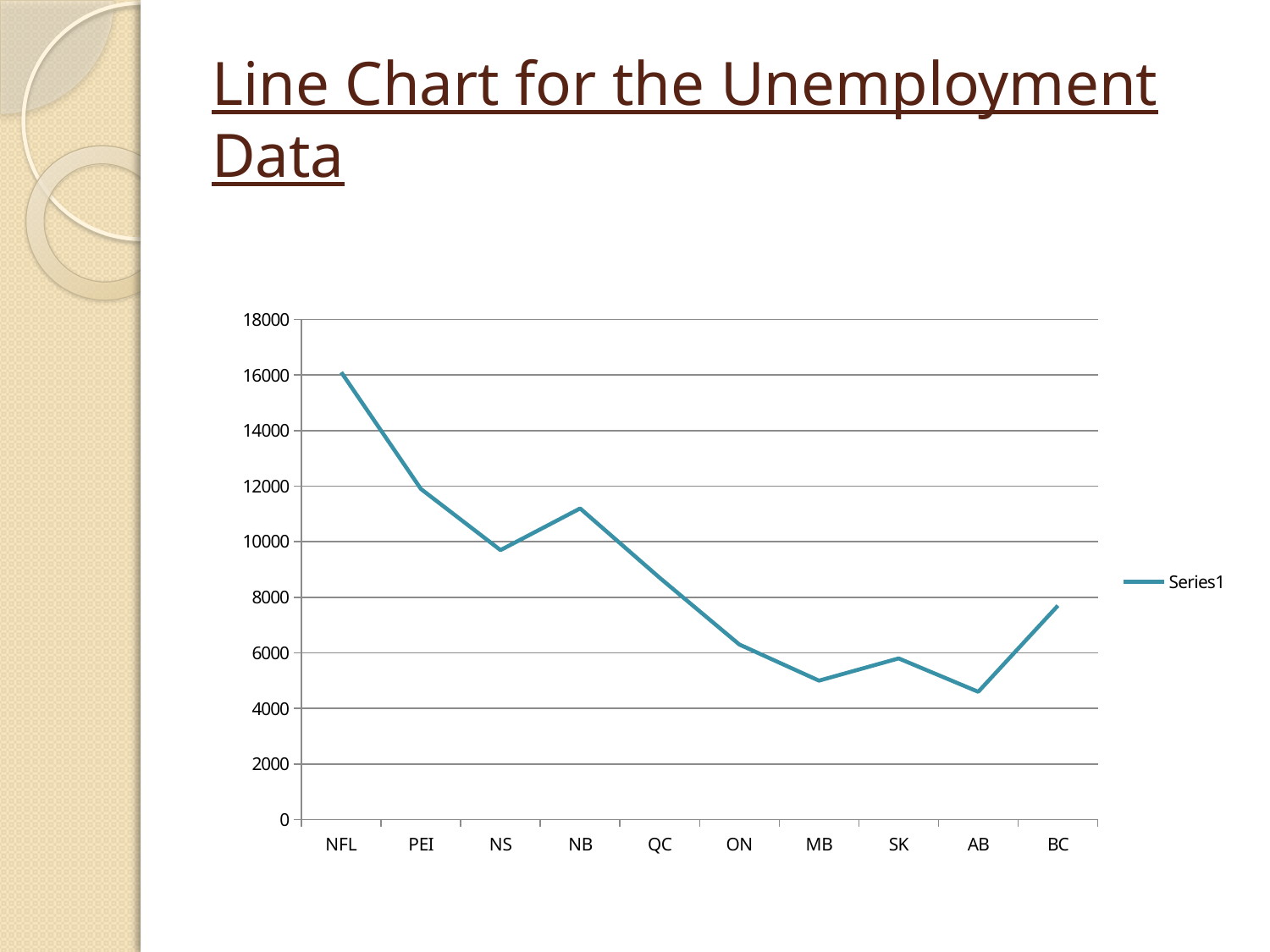
Is the value for PEI greater or less than 14000? less Which province has the highest value on the chart? NFL How many series does the legend list? 1 Do the values rise or fall from NFL to NS? fall Which has the larger value, NS or NB? NB How many provinces are plotted along the x axis? 10 Is the value for ON greater or less than 8000? less Is the value for NB greater or less than 10000? greater What kind of chart is shown on the slide? line chart Which has the larger value, SK or BC? BC Which province has the lowest value on the chart? AB